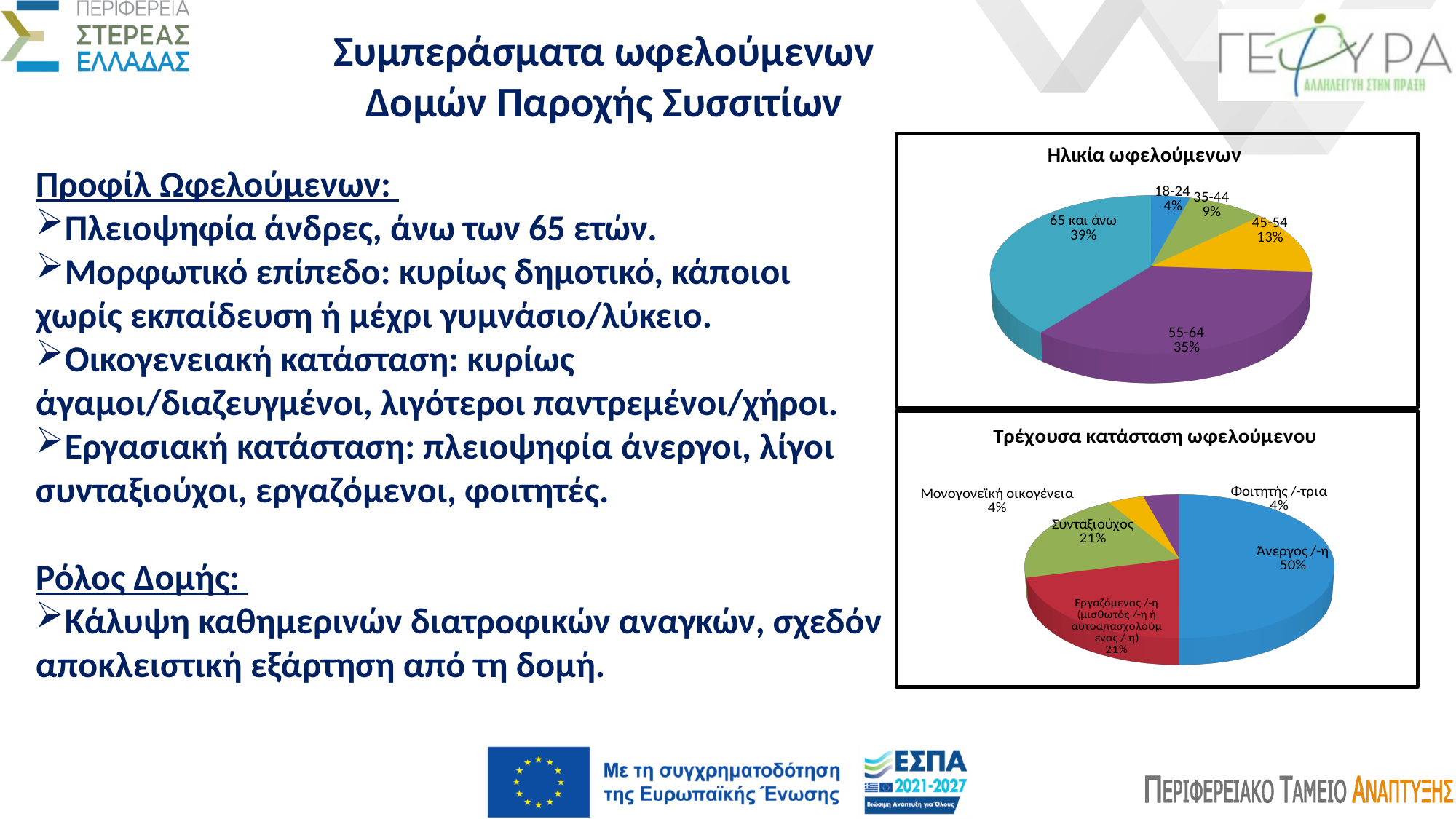
In the 'Ηλικία ωφελούμενων' chart, what percentage is shown for the 55-64 age group? 35% In the 'Τρέχουσα κατάσταση ωφελούμενου' chart, what share is shown for Άνεργος/-η? 50% In the 'Τρέχουσα κατάσταση ωφελούμενου' chart, which category has the largest share? Άνεργος/-η In the 'Τρέχουσα κατάσταση ωφελούμενου' chart, what percentage is shown for Συνταξιούχος? 21% In the 'Ηλικία ωφελούμενων' chart, what is the difference in percentage points between the 45-54 and 35-44 groups? 4 In the 'Ηλικία ωφελούμενων' chart, which age group has the largest share? 65 και άνω What type of chart is 'Τρέχουσα κατάσταση ωφελούμενου'? Pie chart How many categories are shown in the 'Τρέχουσα κατάσταση ωφελούμενου' chart? 5 In the 'Ηλικία ωφελούμενων' chart, what share do beneficiaries aged 65 και άνω represent? 39% How many age groups are shown in the 'Ηλικία ωφελούμενων' chart? 5 In the 'Τρέχουσα κατάσταση ωφελούμενου' chart, is the share for Συνταξιούχος larger or smaller than the share for Φοιτητής/-τρια? Larger In the 'Ηλικία ωφελούμενων' chart, which age group has the smallest share? 18-24